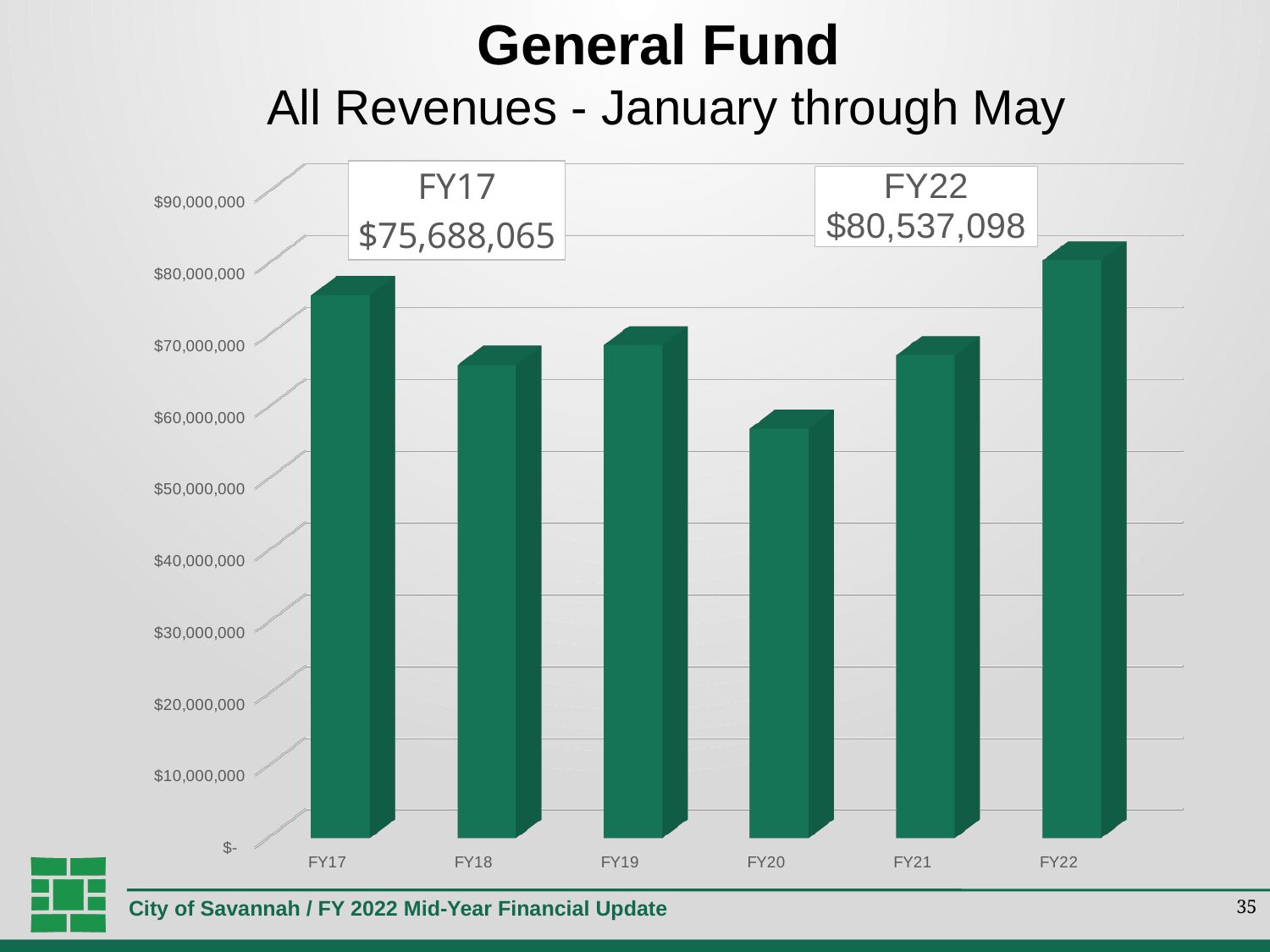
What is the value for FY17? $75,688,065 What is the difference between the FY22 and FY17 values? $4,849,033 Which fiscal year has the highest revenue? FY22 What is the value for FY22? $80,537,098 What kind of chart is shown on the slide? bar chart Which is larger, the value for FY17 or the value for FY22? FY22 Is the value for FY20 greater or less than $60,000,000? less Which fiscal year has the lowest revenue? FY20 Is the value for FY22 greater or less than $80,000,000? greater How many fiscal years are shown on the chart? 6 Which is larger, the value for FY20 or the value for FY21? FY21 Is the value for FY18 greater or less than $60,000,000? greater